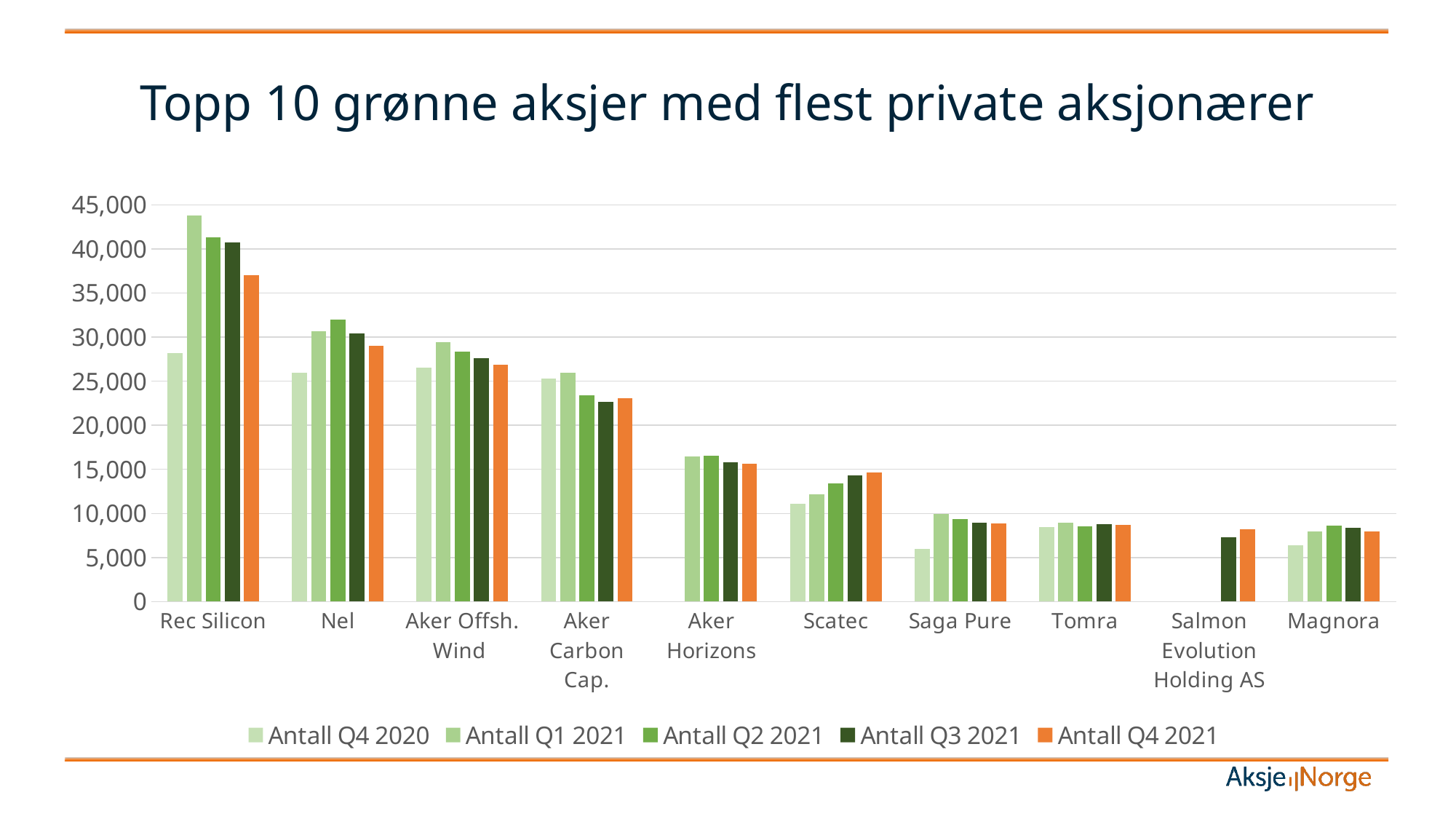
How many companies are shown on the x axis of the chart? 10 Which is larger for Antall Q4 2021: Aker Horizons or Scatec? Aker Horizons Do the Antall Q4 2021 values generally rise or fall moving from Rec Silicon on the left to Magnora on the right? fall Which company has the tallest bar in the chart? Rec Silicon Is the Antall Q4 2021 value for Rec Silicon greater or less than 40,000? less What type of chart is shown on the slide? Bar chart Is the Antall Q1 2021 value for Rec Silicon greater or less than 40,000? greater Which is larger for Antall Q4 2020: Rec Silicon or Nel? Rec Silicon How many series does the legend list? 5 Is the Antall Q4 2020 value for Saga Pure greater or less than 10,000? less Which company has bars for only two of the five quarters? Salmon Evolution Holding AS